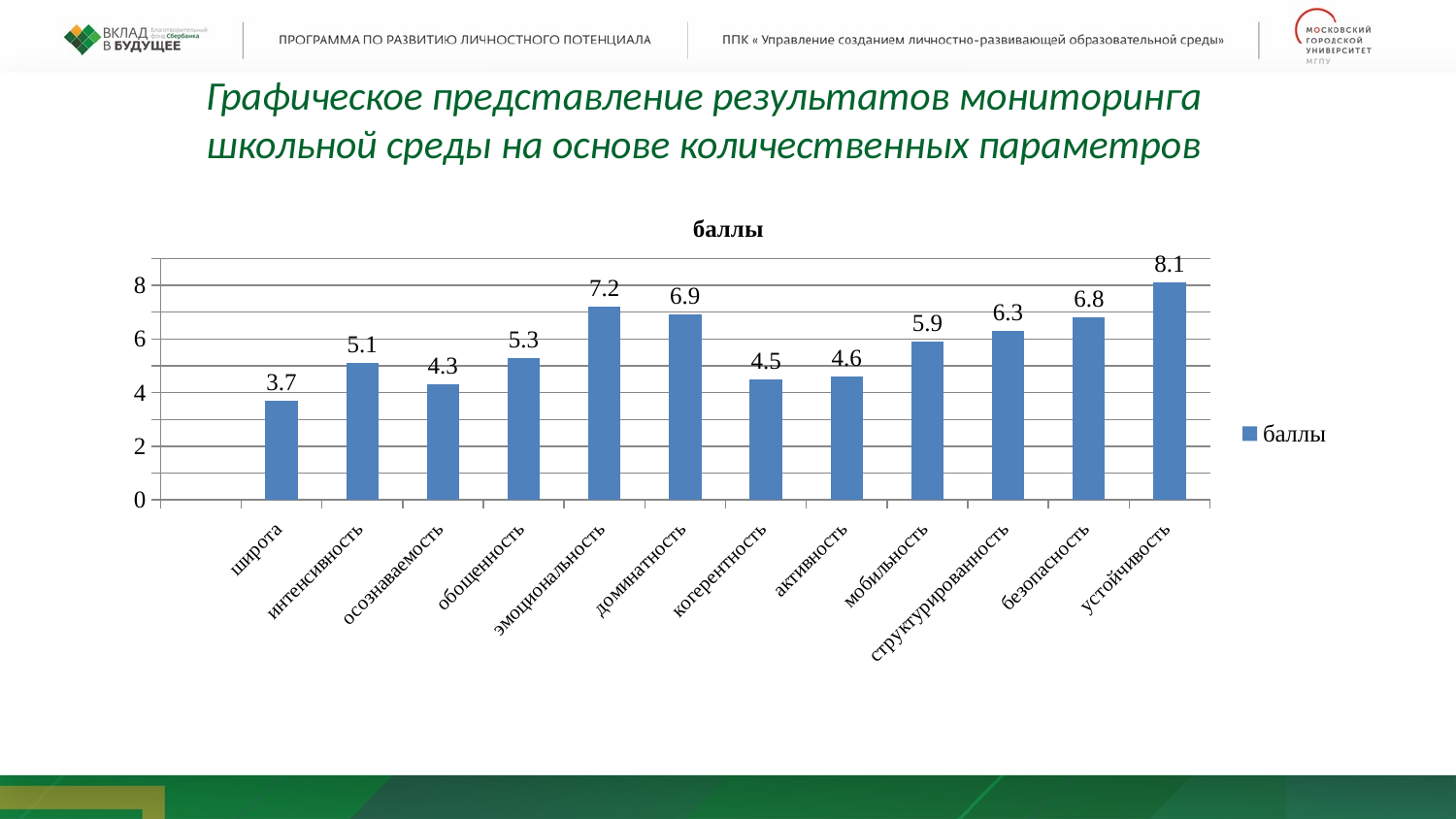
Which category has the highest value? устойчивость Which category has the lowest value? широта How many series does the legend list? 1 Is the value for интенсивность greater or less than 4? greater What kind of chart is shown on the slide? bar chart What is the value for эмоциональность? 7.2 Which is larger, the value for мобильность or the value for безопасность? безопасность What is the difference between the values for устойчивость and широта? 4.4 What is the value for структурированность? 6.3 What is the value for широта? 3.7 How many categories are shown on the x axis? 12 What is the difference between the values for доминантность and когерентность? 2.4